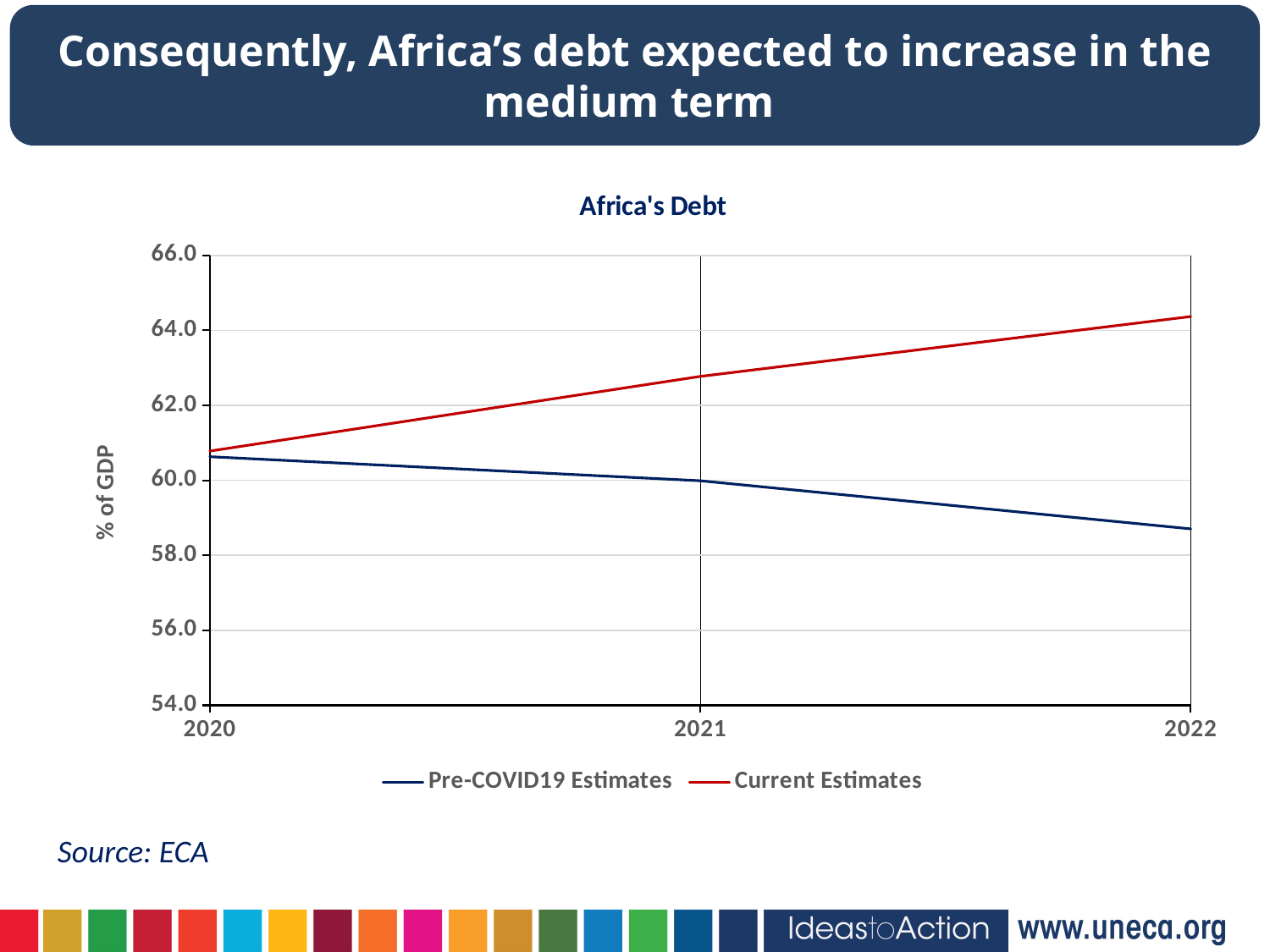
What is the label of the y axis? % of GDP What is the title of the chart? Africa's Debt Is the value for Current Estimates in 2021 greater or less than 62.0? greater Is the value for Current Estimates in 2022 greater or less than 64.0? greater In 2022, which series is higher: Pre-COVID19 Estimates or Current Estimates? Current Estimates What kind of chart is shown on the slide? line chart How many years are shown on the x axis? 3 Is the value for Current Estimates in 2020 greater or less than 62.0? less Do the Current Estimates rise or fall from 2020 to 2022? rise Do the Pre-COVID19 Estimates rise or fall from 2020 to 2022? fall How many series does the legend list? 2